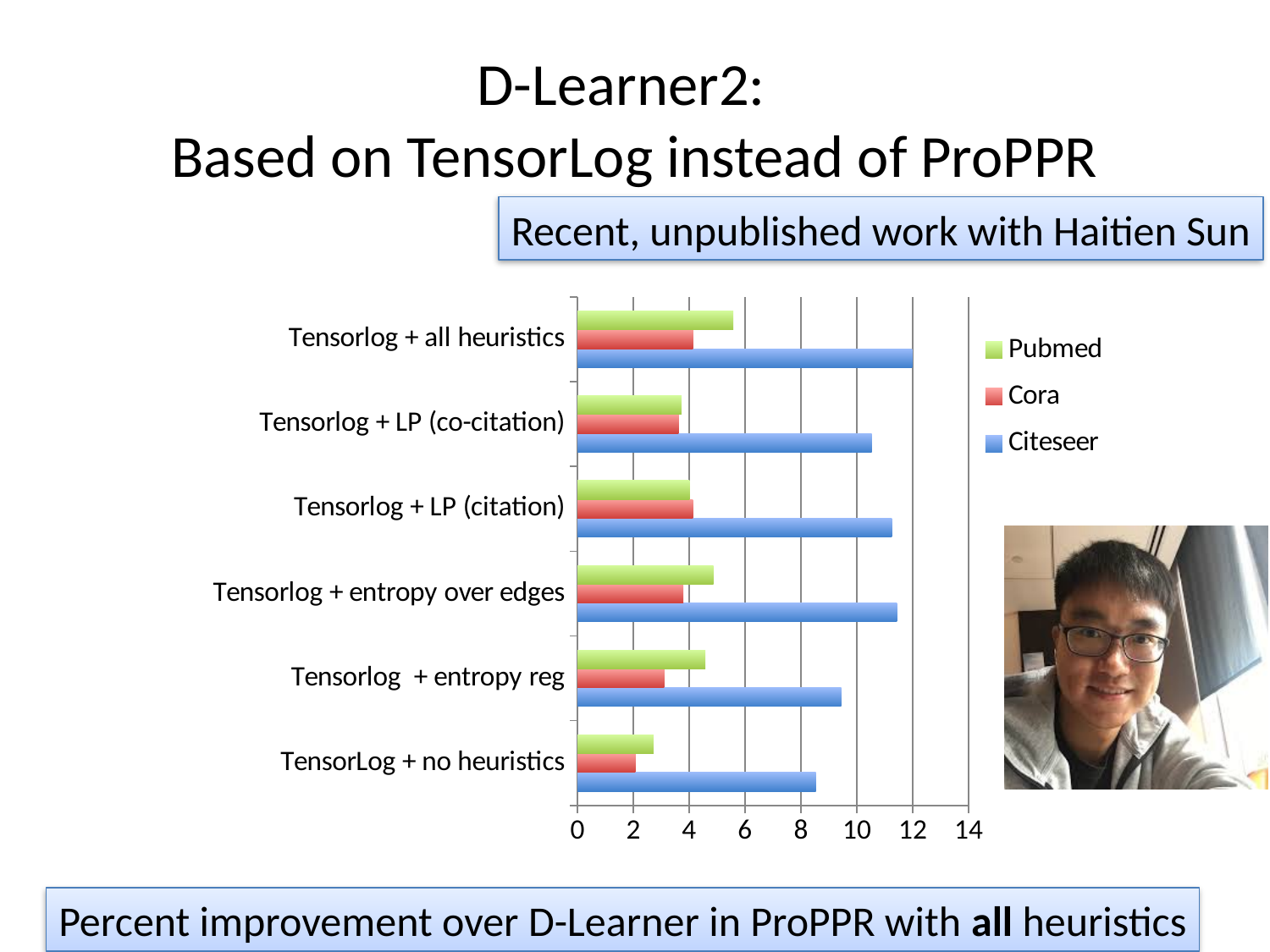
Which series is shown in blue in the chart's legend? Citeseer For 'Tensorlog + all heuristics', which series has the larger value: Pubmed or Cora? Pubmed Is the Citeseer value for 'TensorLog + no heuristics' greater or less than 10? less Is the Citeseer value for 'Tensorlog + entropy reg' greater or less than 10? less For 'Tensorlog + entropy reg', which series has the larger value: Citeseer or Pubmed? Citeseer How many categories (TensorLog variants) are shown on the chart's vertical axis? 6 Which category has the lowest Citeseer value? TensorLog + no heuristics Is the Pubmed value for 'TensorLog + no heuristics' greater or less than 4? less What kind of chart is shown on the slide? bar chart Which category has the highest Pubmed value? Tensorlog + all heuristics How many series does the chart's legend list? 3